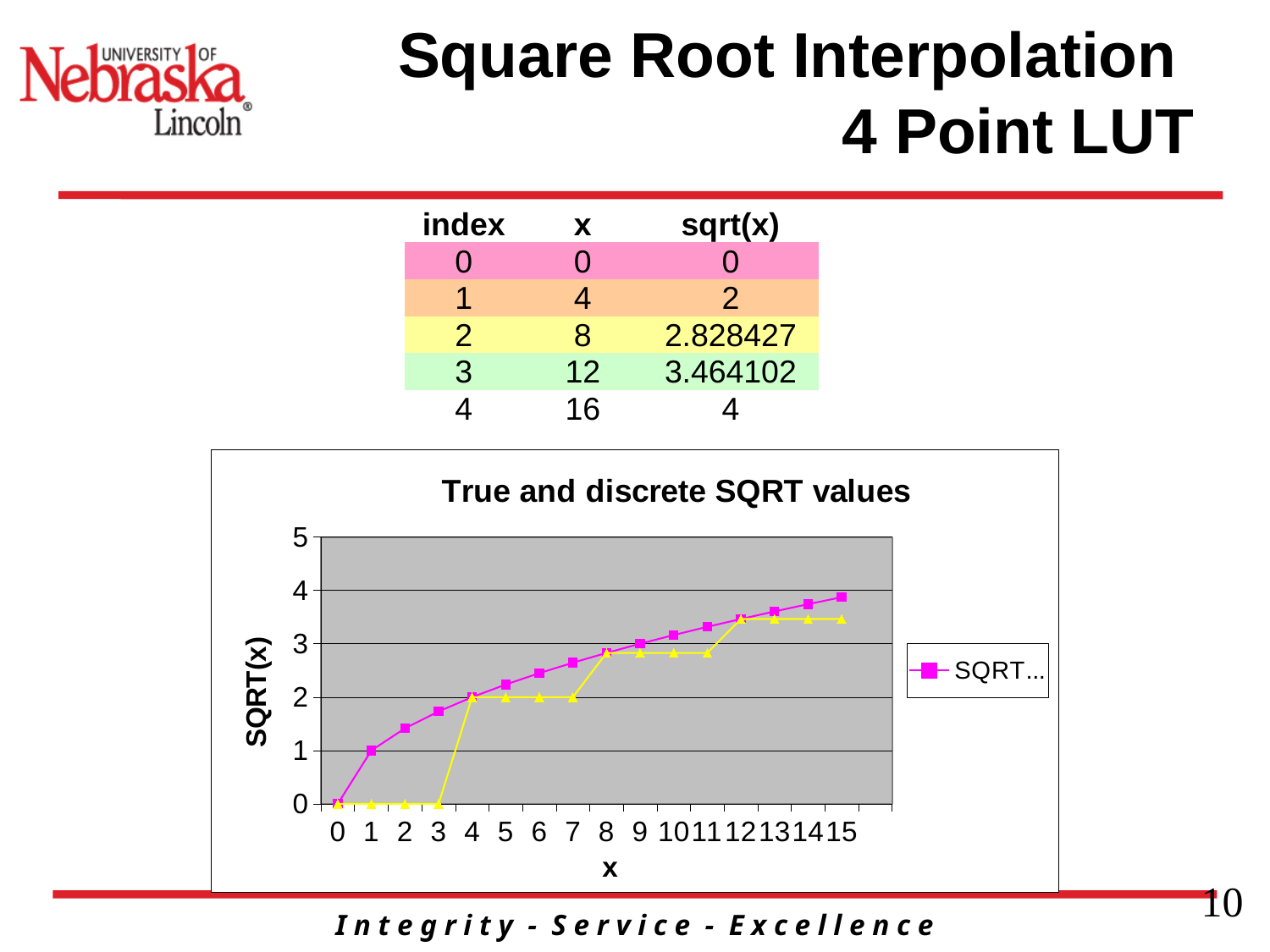
What kind of chart is shown on the slide? line chart How many x values (0 through 15) are plotted along the x axis of the chart? 16 What is the value of the magenta (true SQRT) line at x = 4? 2 What is the label on the vertical axis of the chart? SQRT(x) At x = 2, which line has the larger value, the magenta line or the yellow line? magenta What is the value of the yellow (discrete) line at x = 6? 2 What is the value of the magenta (true SQRT) line at x = 1? 1 Is the value of the yellow line at x = 13 greater or less than 3? greater Is the value of the magenta line at x = 9 greater or less than 2? greater What is the value of the yellow (discrete) line at x = 2? 0 How many lines are plotted in the chart? 2 What is the title of the chart? True and discrete SQRT values